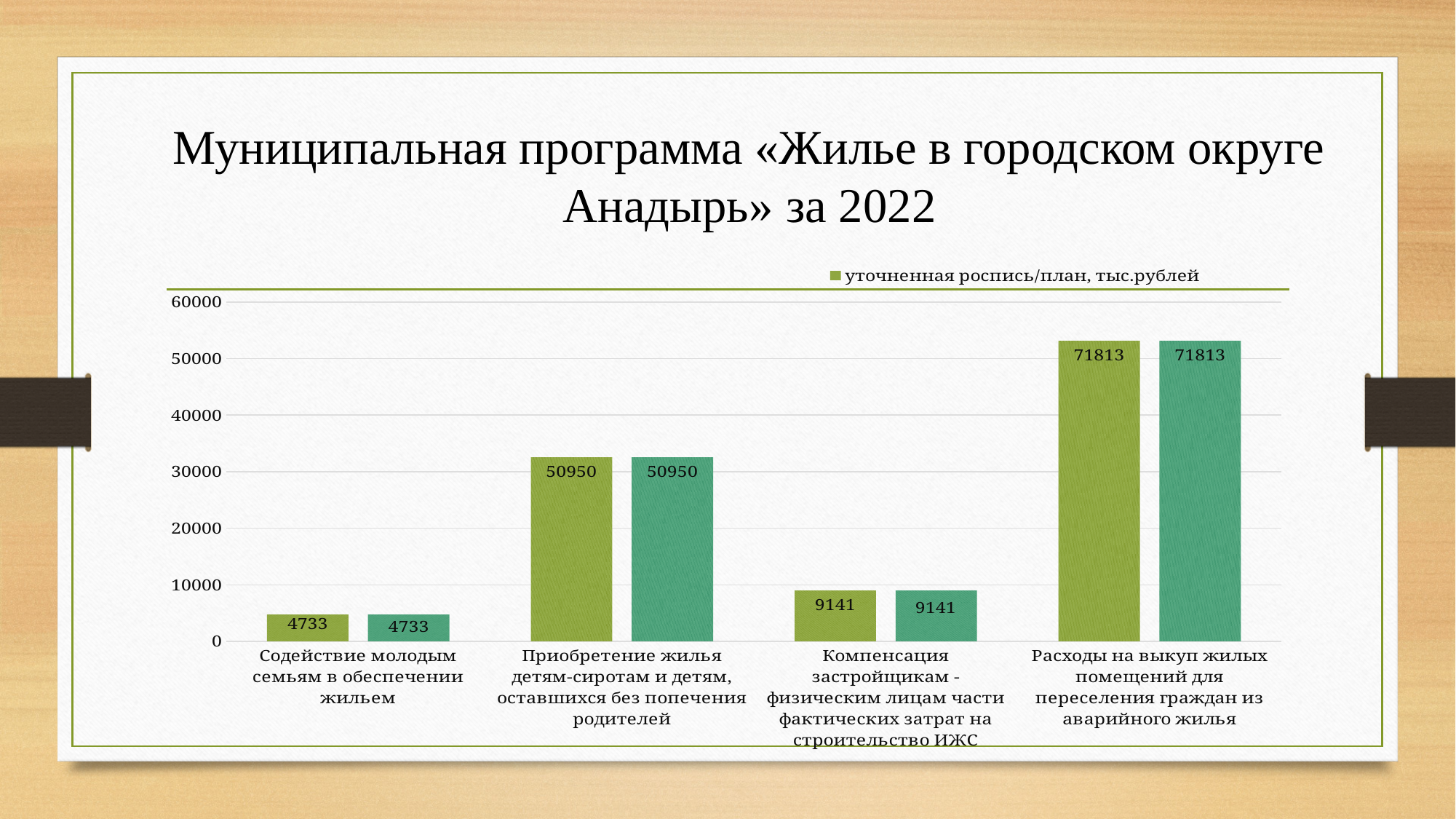
What value is shown for «Содействие молодым семьям в обеспечении жильем»? 4733 How many entries does the legend list? 1 What is the legend entry shown above the chart? уточненная роспись/план, тыс.рублей Which category has the lowest value? Содействие молодым семьям в обеспечении жильем What value is shown for «Приобретение жилья детям-сиротам и детям, оставшихся без попечения родителей»? 50950 What value is shown for «Компенсация застройщикам - физическим лицам части фактических затрат на строительство ИЖС»? 9141 Which is larger: the value for «Компенсация застройщикам...» or the value for «Содействие молодым семьям...»? Компенсация застройщикам - физическим лицам части фактических затрат на строительство ИЖС Which category has the highest value? Расходы на выкуп жилых помещений для переселения граждан из аварийного жилья How many categories are shown on the x axis? 4 What value is shown for «Расходы на выкуп жилых помещений для переселения граждан из аварийного жилья»? 71813 What kind of chart is shown on the slide? Bar chart What is the difference between the value for «Приобретение жилья детям-сиротам...» and the value for «Компенсация застройщикам...»? 41809